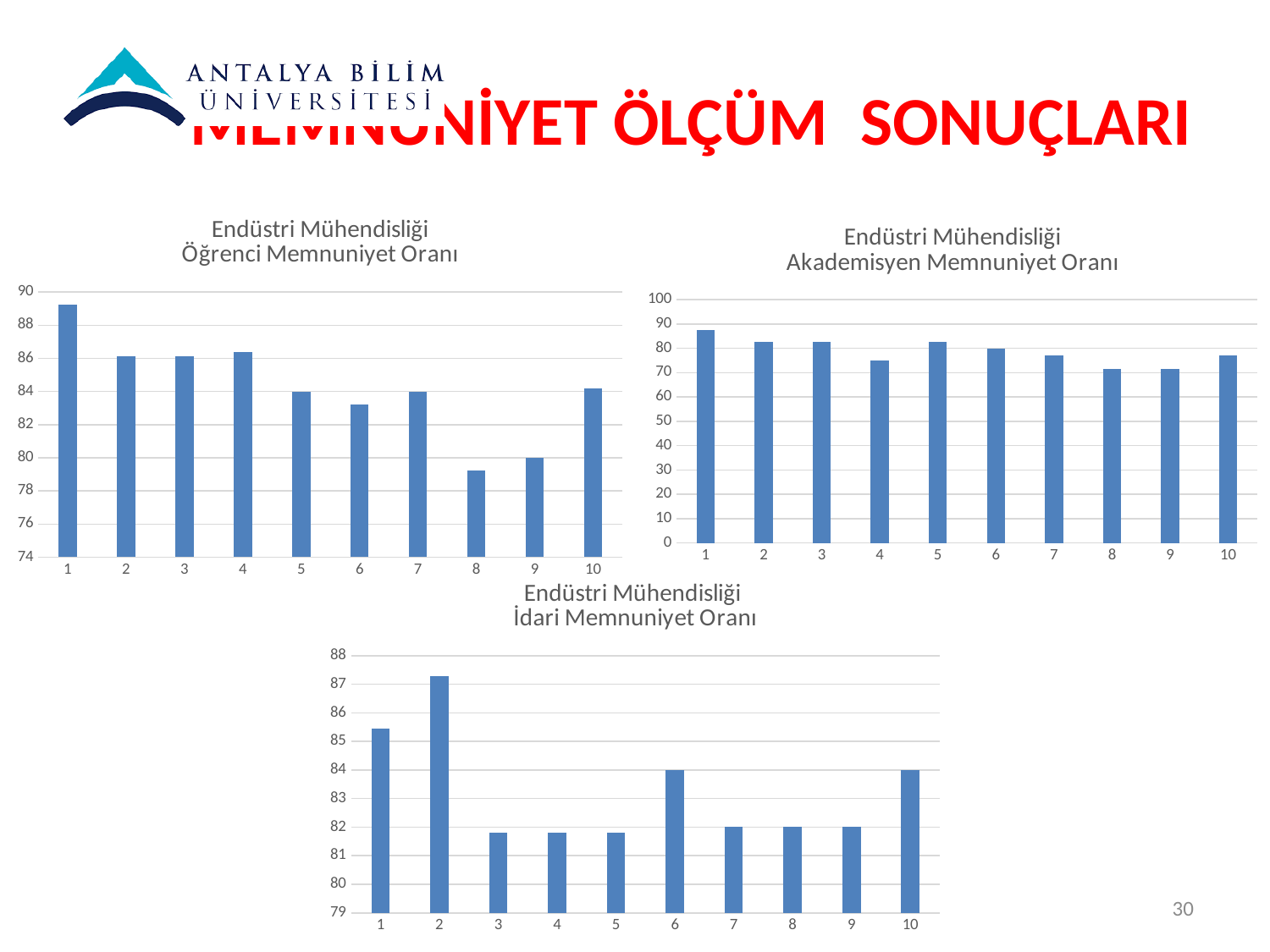
In the 'Endüstri Mühendisliği İdari Memmuniyet Oranı' chart, which category has the highest value? 2 In the 'Endüstri Mühendisliği Öğrenci Memnuniyet Oranı' chart, which category has the lowest value? 8 In the 'Endüstri Mühendisliği Akademisyen Memnuniyet Oranı' chart, is the value for category 4 greater or less than 80? less In the 'Endüstri Mühendisliği Öğrenci Memnuniyet Oranı' chart, is the value for category 8 greater or less than 80? less In the 'Endüstri Mühendisliği Öğrenci Memnuniyet Oranı' chart, which category has the highest value? 1 In the 'Endüstri Mühendisliği Öğrenci Memnuniyet Oranı' chart, is the value for category 1 greater or less than 88? greater In the 'Endüstri Mühendisliği Akademisyen Memnuniyet Oranı' chart, which category has the highest value? 1 In the 'Endüstri Mühendisliği Akademisyen Memnuniyet Oranı' chart, which is larger, the value for category 1 or category 8? category 1 In the 'Endüstri Mühendisliği İdari Memmuniyet Oranı' chart, which is larger, the value for category 1 or category 3? category 1 How many categories are shown in the 'Endüstri Mühendisliği Akademisyen Memnuniyet Oranı' chart? 10 What type of chart is the 'Endüstri Mühendisliği Öğrenci Memnuniyet Oranı' chart? bar chart